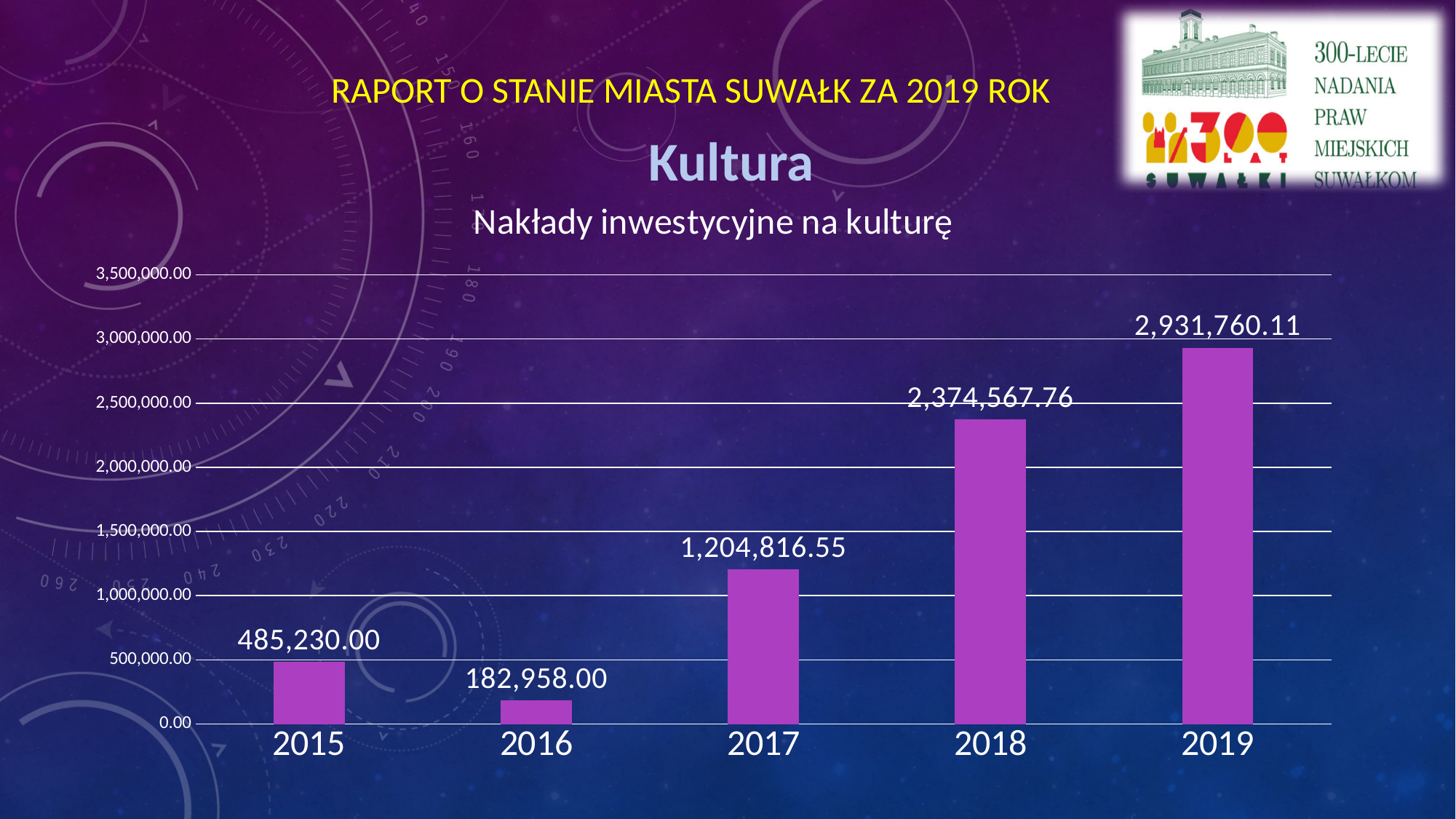
How many years are shown on the x axis? 5 What kind of chart is shown? bar chart Which is larger, the value for 2015 or the value for 2017? 2017 What is the value for 2019? 2,931,760.11 What is the title of the chart? Nakłady inwestycyjne na kulturę What is the value for 2017? 1,204,816.55 Which year has the lowest value? 2016 What is the difference between the values for 2019 and 2018? 557,192.35 What is the value for 2016? 182,958.00 Which year has the highest value? 2019 Is the value for 2018 greater or less than 2,000,000.00? greater What is the difference between the values for 2015 and 2016? 302,272.00